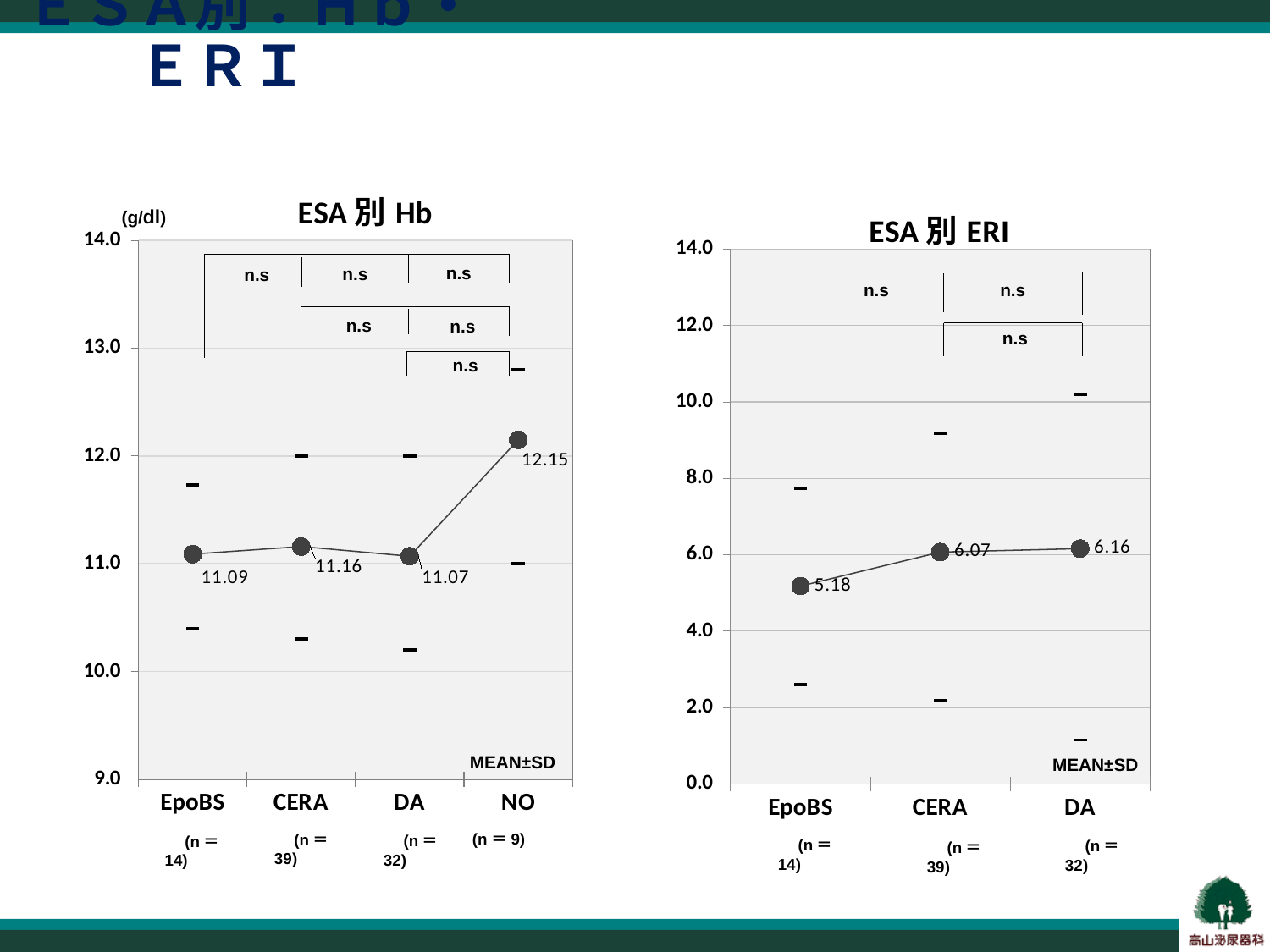
In the ESA 別 Hb chart, how many categories are plotted on the x axis? 4 In the ESA 別 Hb chart, which category has the highest value? NO In the ESA 別 Hb chart, what is the value for NO? 12.15 In the ESA 別 Hb chart, what is the difference between the values for NO and DA? 1.08 In the ESA 別 Hb chart, what is the value for CERA? 11.16 In the ESA 別 ERI chart, which category has the lowest value? EpoBS In the ESA 別 ERI chart, how many categories are plotted on the x axis? 3 In the ESA 別 Hb chart, what unit is shown on the y axis? g/dl In the ESA 別 ERI chart, what is the difference between the values for CERA and EpoBS? 0.89 In the ESA 別 Hb chart, is the value for EpoBS greater or less than 12.0? less In the ESA 別 ERI chart, what is the value for EpoBS? 5.18 In the ESA 別 ERI chart, what is the value for DA? 6.16